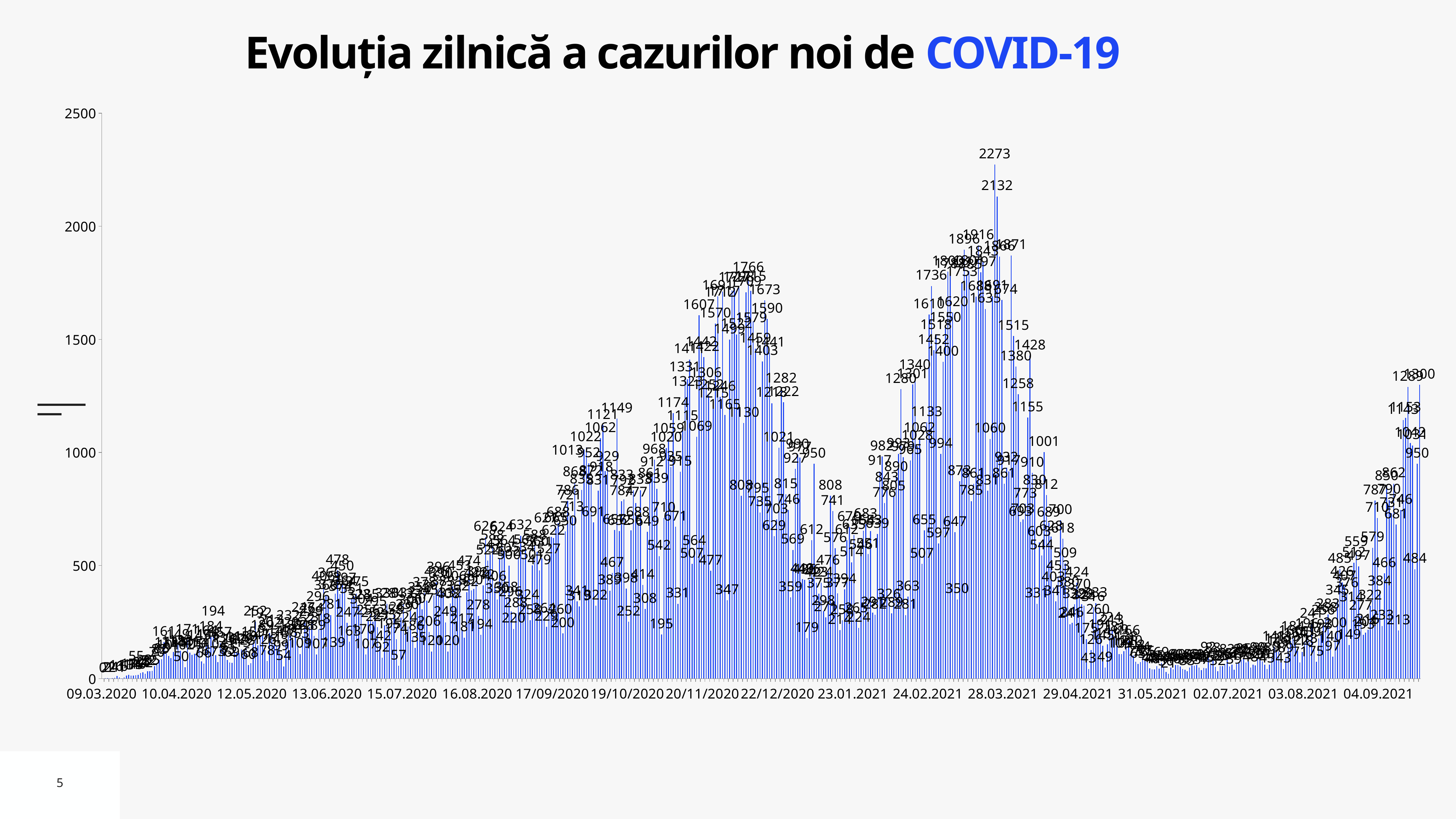
Is the highest bar on the chart greater or less than 2000? greater What is the title of the chart? Evoluția zilnică a cazurilor noi de COVID-19 What is the highest value labelled on the chart? 2273 Are the bars around 31.05.2021 greater or less than 500? less What is the highest tick value shown on the y axis? 2500 Do the values rise or fall along the x axis between 03.08.2021 and 04.09.2021? rise Which is larger, the peak labelled 2273 or the neighbouring peak labelled 2132? 2273 Do the values rise or fall along the x axis between 28.03.2021 and 31.05.2021? fall What is the difference between the two highest labelled values, 2273 and 2132? 141 What kind of chart is shown on the slide? bar chart How many date labels are shown on the x axis? 18